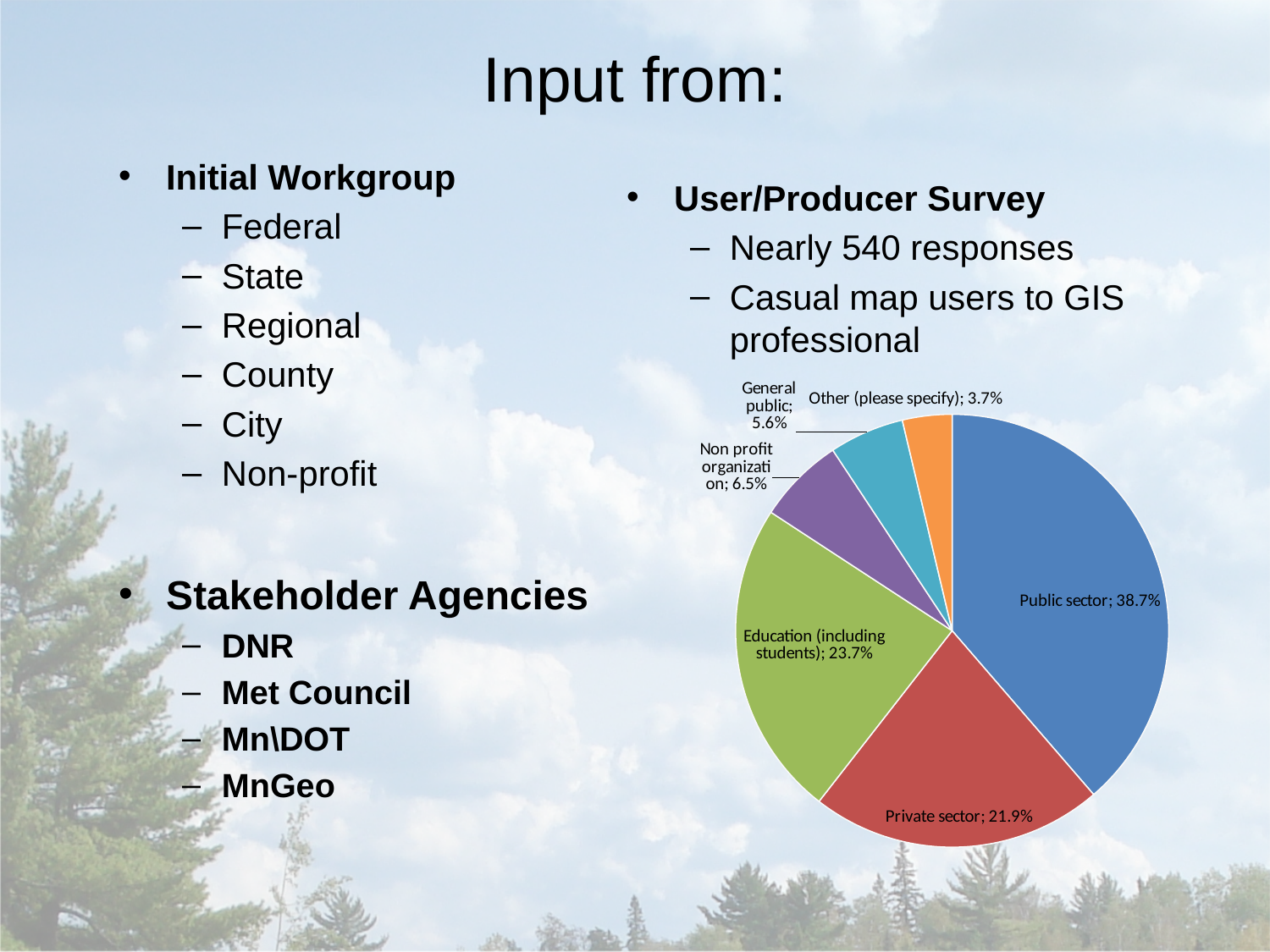
Which slice of the pie chart is the largest? Public sector Which is larger, the Education (including students) slice or the Private sector slice? Education (including students) What share of the pie does Other (please specify) have? 3.7% What share of the pie does Private sector have? 21.9% What share of the pie does Non profit organization have? 6.5% What share of the pie does Education (including students) have? 23.7% What share of the pie does Public sector have? 38.7% Which slice of the pie chart is the smallest? Other (please specify) What kind of chart is shown on the slide? pie chart What is the difference between the Public sector and Private sector shares? 16.8% How many slices does the pie chart have? 6 What share of the pie does General public have? 5.6%